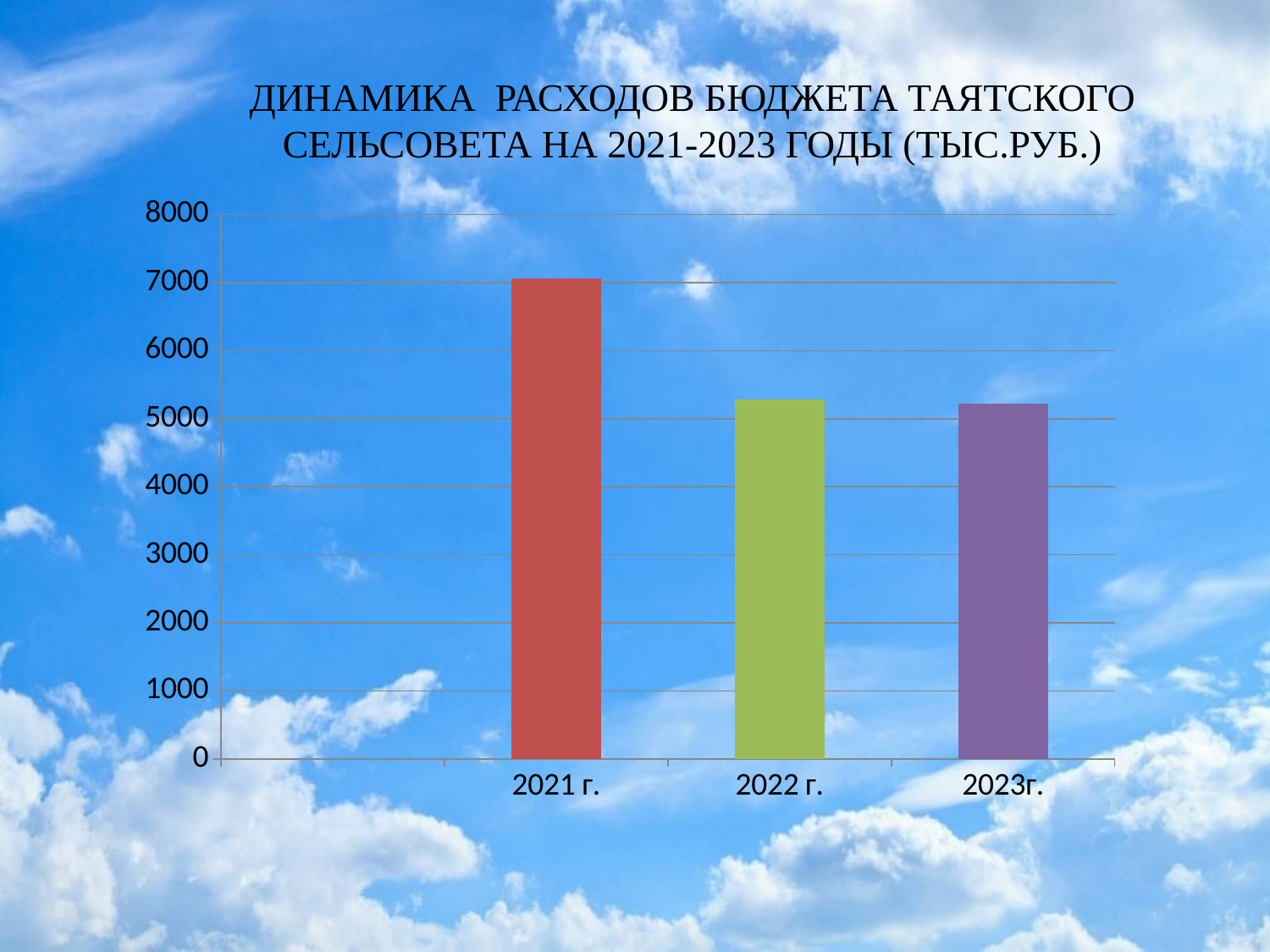
Which year has the highest budget expenditure in the chart? 2021 г. Which is larger, the value for 2021 г. or the value for 2022 г.? 2021 г. Is the value for 2021 г. greater or less than 6000? greater Is the value for 2022 г. greater or less than 6000? less Is the value for 2023г. greater or less than 6000? less What kind of chart is shown on the slide? bar chart What is the title of the chart? ДИНАМИКА РАСХОДОВ БЮДЖЕТА ТАЯТСКОГО СЕЛЬСОВЕТА НА 2021-2023 ГОДЫ (ТЫС.РУБ.) Do the values rise or fall from 2021 г. to 2023г.? fall How many bars (years) are plotted in the chart? 3 What colour is the bar for 2021 г.? red